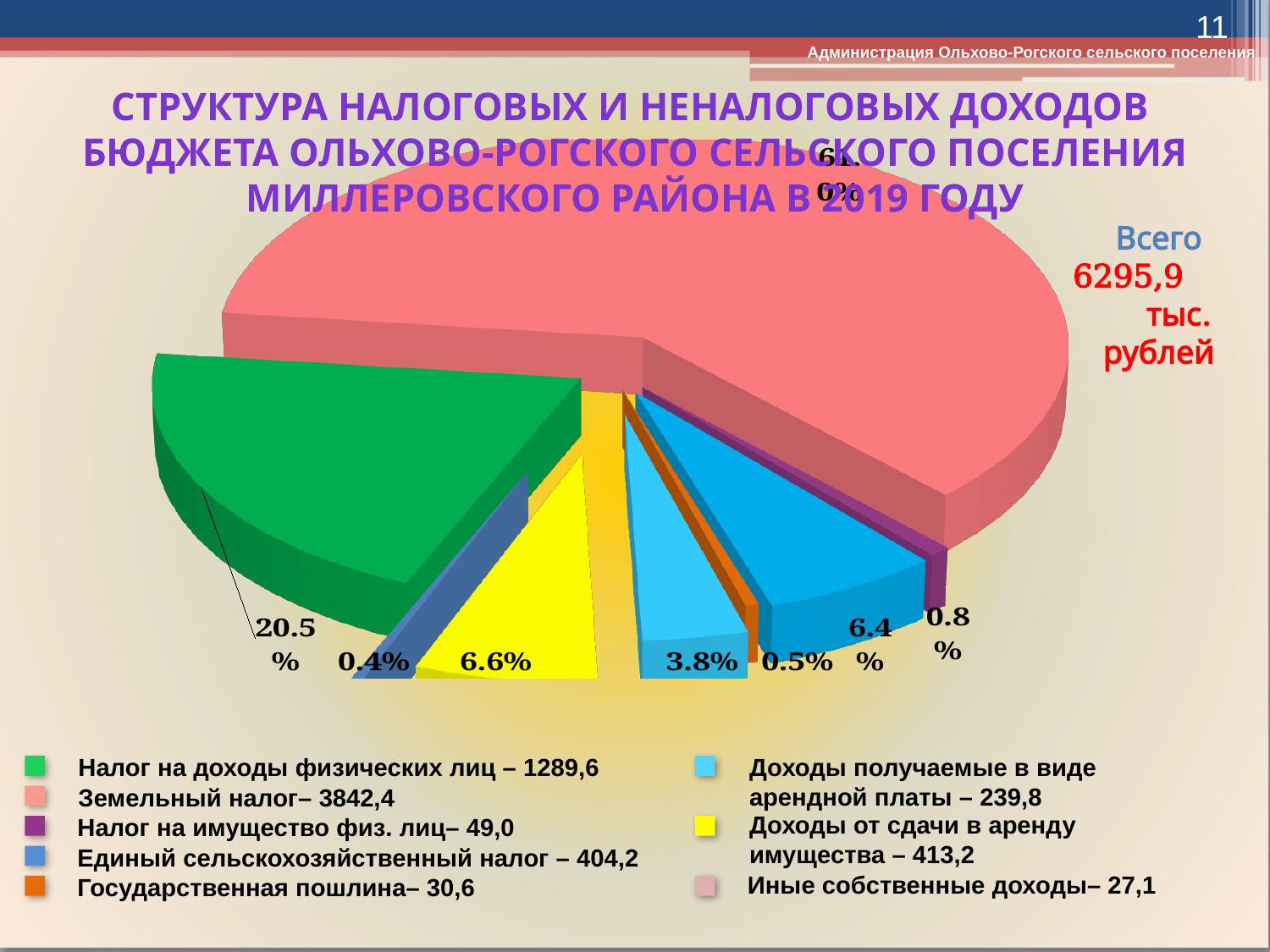
What is the difference in percentage points between the share of Налог на доходы физических лиц (20.5%) and the share of Доходы от сдачи в аренду имущества (6.6%)? 13.9% What share of the pie does Единый сельскохозяйственный налог (blue slice) have? 6.4% Which category has the smallest slice of the pie? Иные собственные доходы Which category has the largest slice of the pie? Земельный налог According to the legend, what is the value for Земельный налог? 3842,4 What share of the pie does Налог на доходы физических лиц (green slice) have? 20.5% What share of the pie does Доходы от сдачи в аренду имущества (yellow slice) have? 6.6% What kind of chart is shown on the slide? pie chart How many categories does the legend of the pie chart list? 8 What total amount (Всего) is shown next to the pie chart? 6295,9 тыс. рублей Which is larger: the share for Доходы получаемые в виде арендной платы or the share for Налог на имущество физ. лиц? Доходы получаемые в виде арендной платы